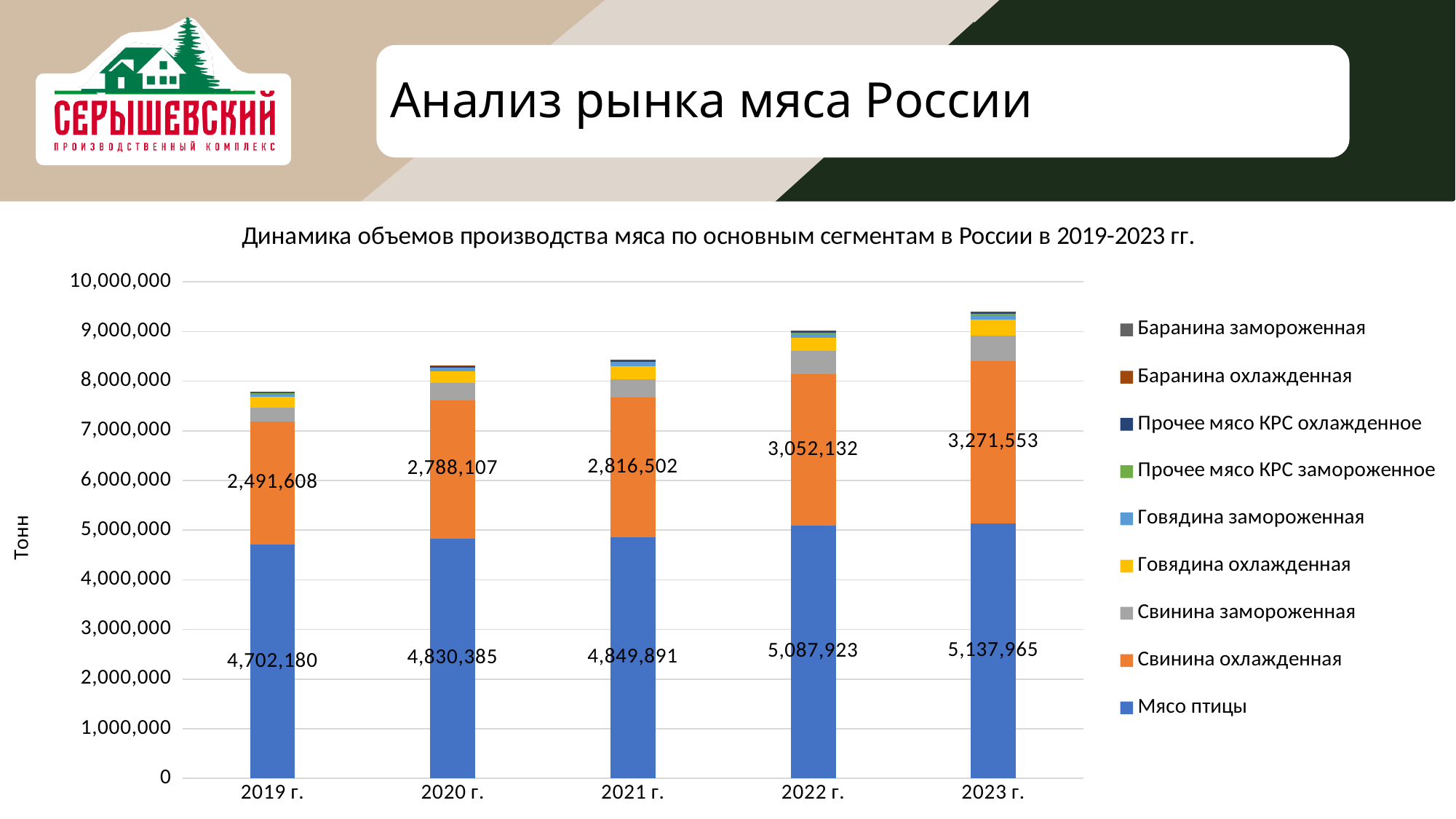
How many series does the legend list? 9 What is the difference between the Свинина охлажденная values for 2022 г. and 2021 г.? 235,630 Is the total height of the stacked bar for 2023 г. greater or less than 9,000,000? greater In which year is the value for Свинина охлажденная the lowest? 2019 г. How many years are shown on the x axis? 5 Do the Мясо птицы values rise or fall from 2019 г. to 2023 г.? rise What is the value for Мясо птицы in 2019 г.? 4,702,180 In which year is the value for Мясо птицы the highest? 2023 г. What is the difference between the Мясо птицы values for 2023 г. and 2019 г.? 435,785 What is the value for Свинина охлажденная in 2022 г.? 3,052,132 What is the value for Мясо птицы in 2023 г.? 5,137,965 In 2020 г., which is larger: Мясо птицы or Свинина охлажденная? Мясо птицы